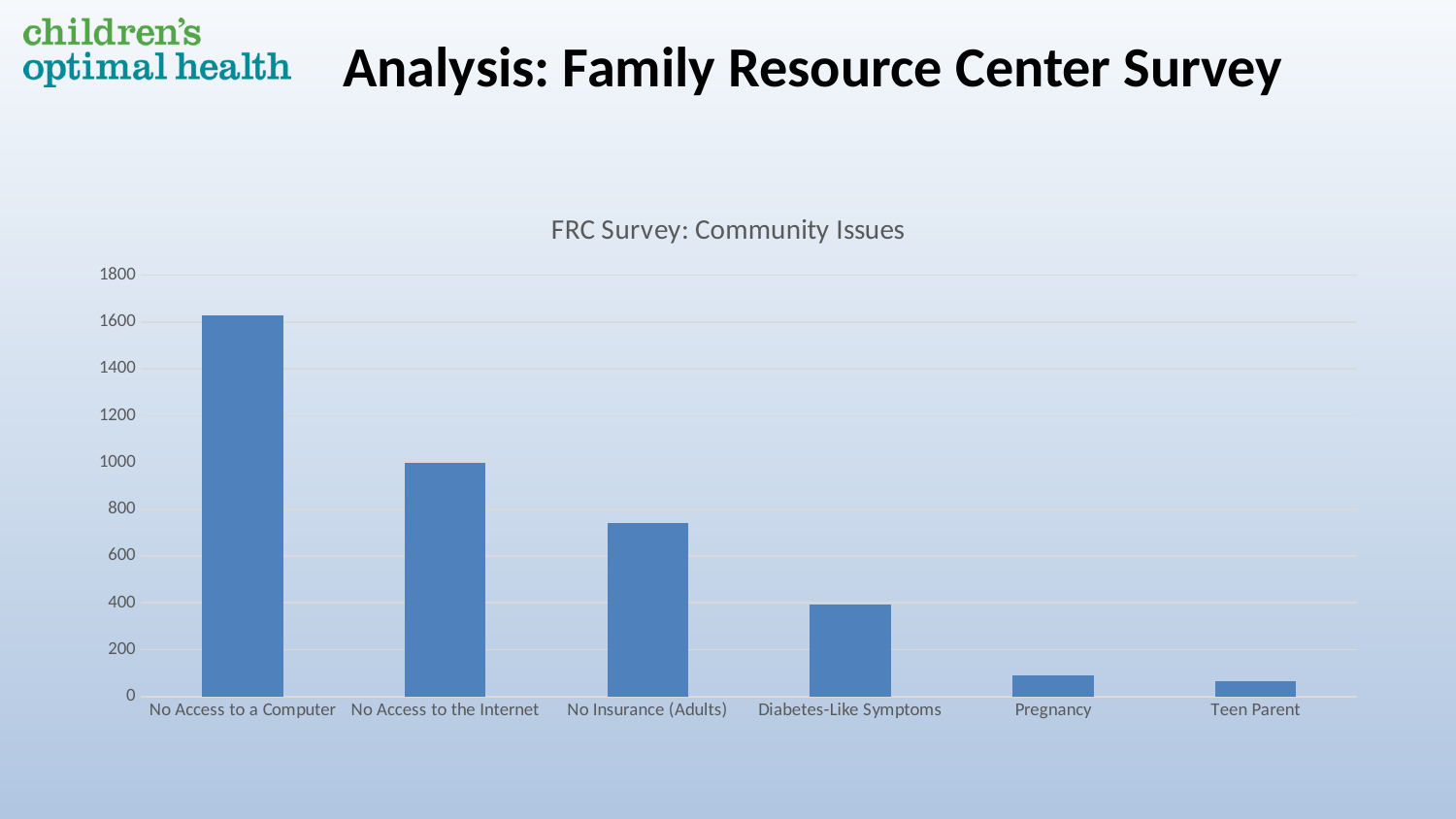
What kind of chart is shown on the slide? bar chart Which is larger, the value for Pregnancy or the value for No Access to the Internet? No Access to the Internet What is the title of the chart? FRC Survey: Community Issues Which category has the lowest value? Teen Parent Which category has the highest value? No Access to a Computer How many categories are plotted in the chart? 6 Is the value for No Insurance (Adults) greater or less than 800? less Is the value for Diabetes-Like Symptoms greater or less than 200? greater Is the value for Pregnancy greater or less than 200? less Do the values rise or fall moving from left to right across the categories? fall Which is larger, the value for No Insurance (Adults) or the value for Diabetes-Like Symptoms? No Insurance (Adults)